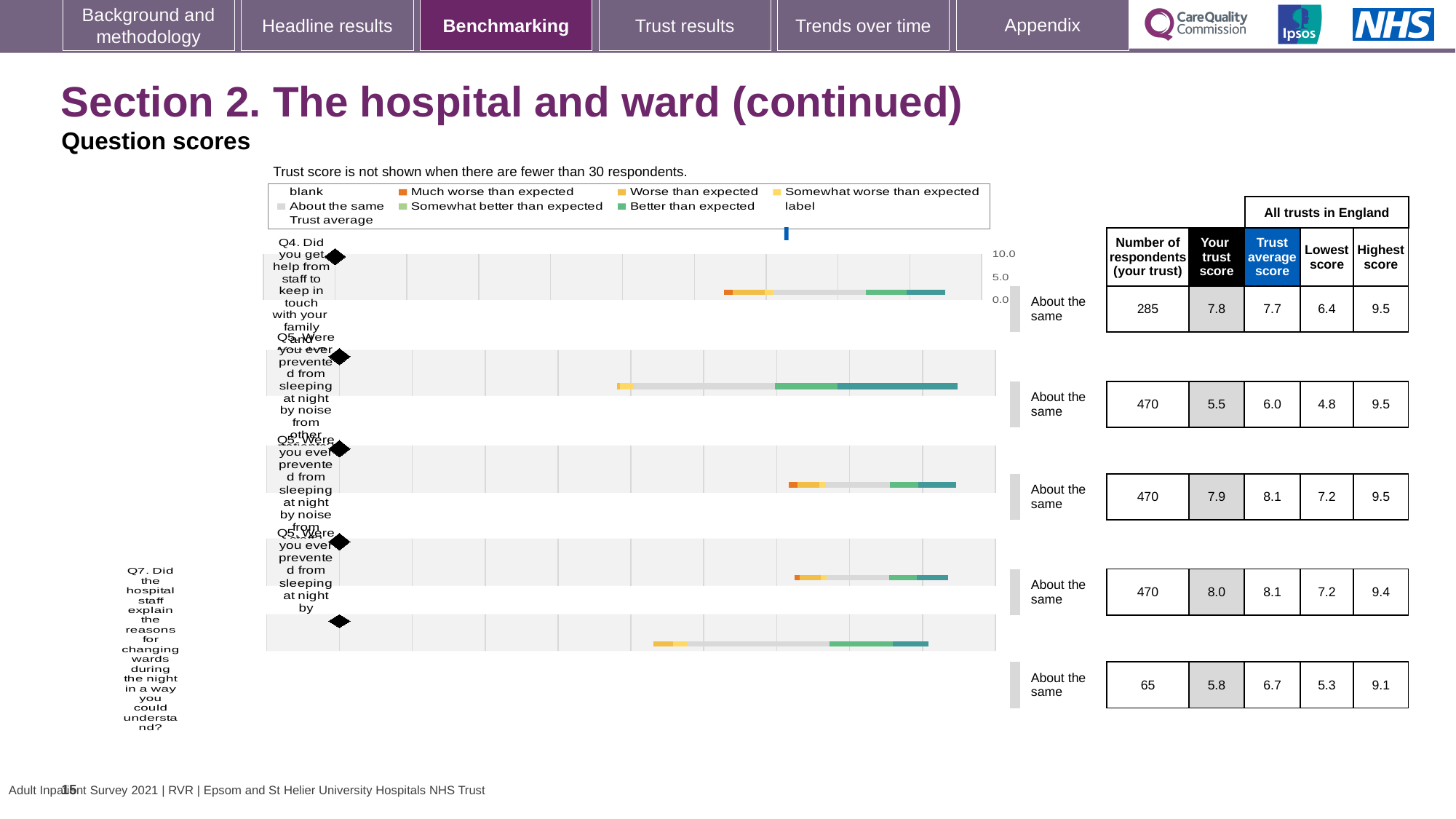
What is the 'Your trust score' for Q7 (explaining reasons for changing wards during the night)? 5.8 What is the difference between the trust average score and this trust's score for Q7? 0.9 According to the note above the chart, when is the trust score not shown? When there are fewer than 30 respondents What kind of chart is used to show the question scores on this slide? bar chart How many question rows are plotted in the chart? 5 For Q4, which is higher: this trust's score or the trust average score? Your trust score What is the trust average score for Q7? 6.7 How many respondents answered Q4 for this trust? 285 Is this trust's score for Q4 greater or less than 5.0? greater Which question row has the fewest respondents? Q7 What is the 'Your trust score' for Q4 (help from staff to keep in touch with family and friends)? 7.8 What benchmark category is shown for every question row on this slide? About the same